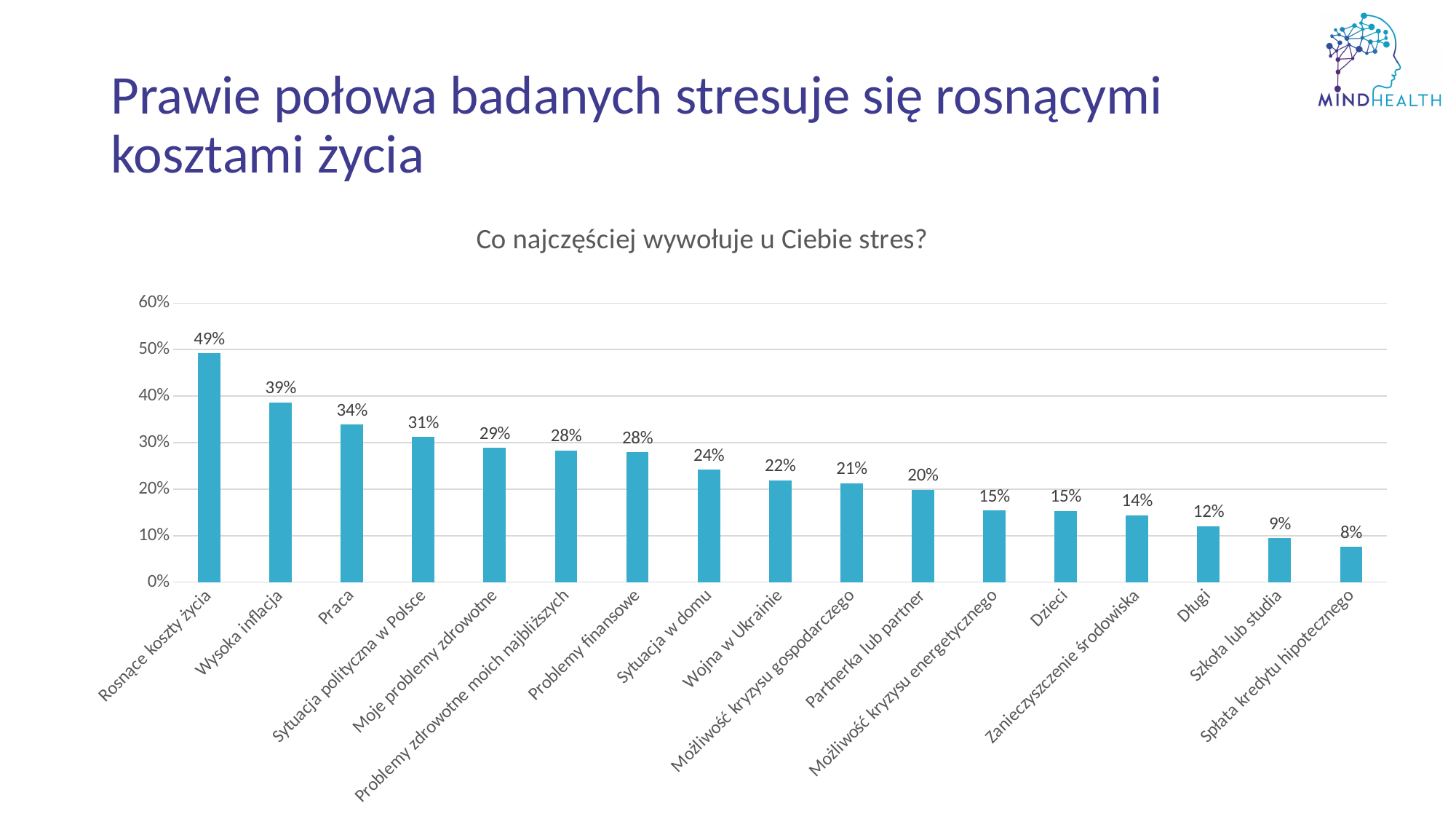
What is the value for Zanieczyszczenie środowiska? 14% What is the value for Wojna w Ukrainie? 22% How many categories are shown in the chart? 17 Is the value for Długi greater or less than 10%? greater Which is larger, the value for Sytuacja w domu or the value for Partnerka lub partner? Sytuacja w domu What is the title of the chart? Co najczęściej wywołuje u Ciebie stres? Which category has the highest value? Rosnące koszty życia What is the difference between the values for Rosnące koszty życia and Spłata kredytu hipotecznego? 41% What is the difference between the values for Wysoka inflacja and Praca? 5% What kind of chart is shown on the slide? Bar chart Which category has the lowest value? Spłata kredytu hipotecznego What is the value for Rosnące koszty życia? 49%